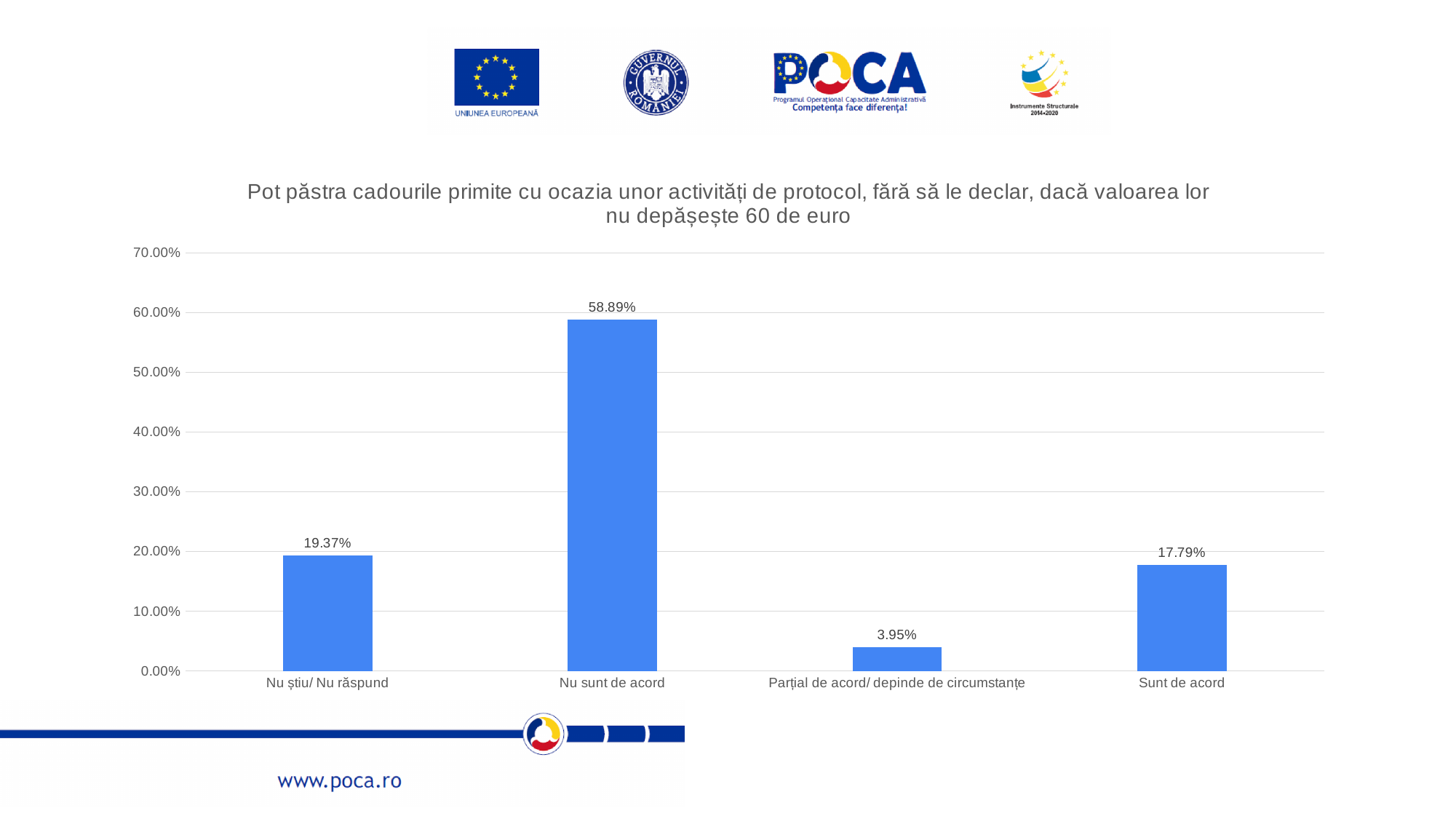
What is the value for "Nu știu/ Nu răspund"? 19.37% What is the difference between the values for "Nu sunt de acord" and "Sunt de acord"? 41.10% What is the value for "Nu sunt de acord"? 58.89% What kind of chart is shown on the slide? bar chart Which category has the highest value? Nu sunt de acord What is the value for "Sunt de acord"? 17.79% How many categories are shown on the x axis? 4 What is the value for "Parțial de acord/ depinde de circumstanțe"? 3.95% Which is larger, the value for "Nu știu/ Nu răspund" or the value for "Parțial de acord/ depinde de circumstanțe"? Nu știu/ Nu răspund What is the difference between the values for "Nu știu/ Nu răspund" and "Sunt de acord"? 1.58% Is the value for "Nu sunt de acord" greater or less than 50.00%? greater Which category has the lowest value? Parțial de acord/ depinde de circumstanțe